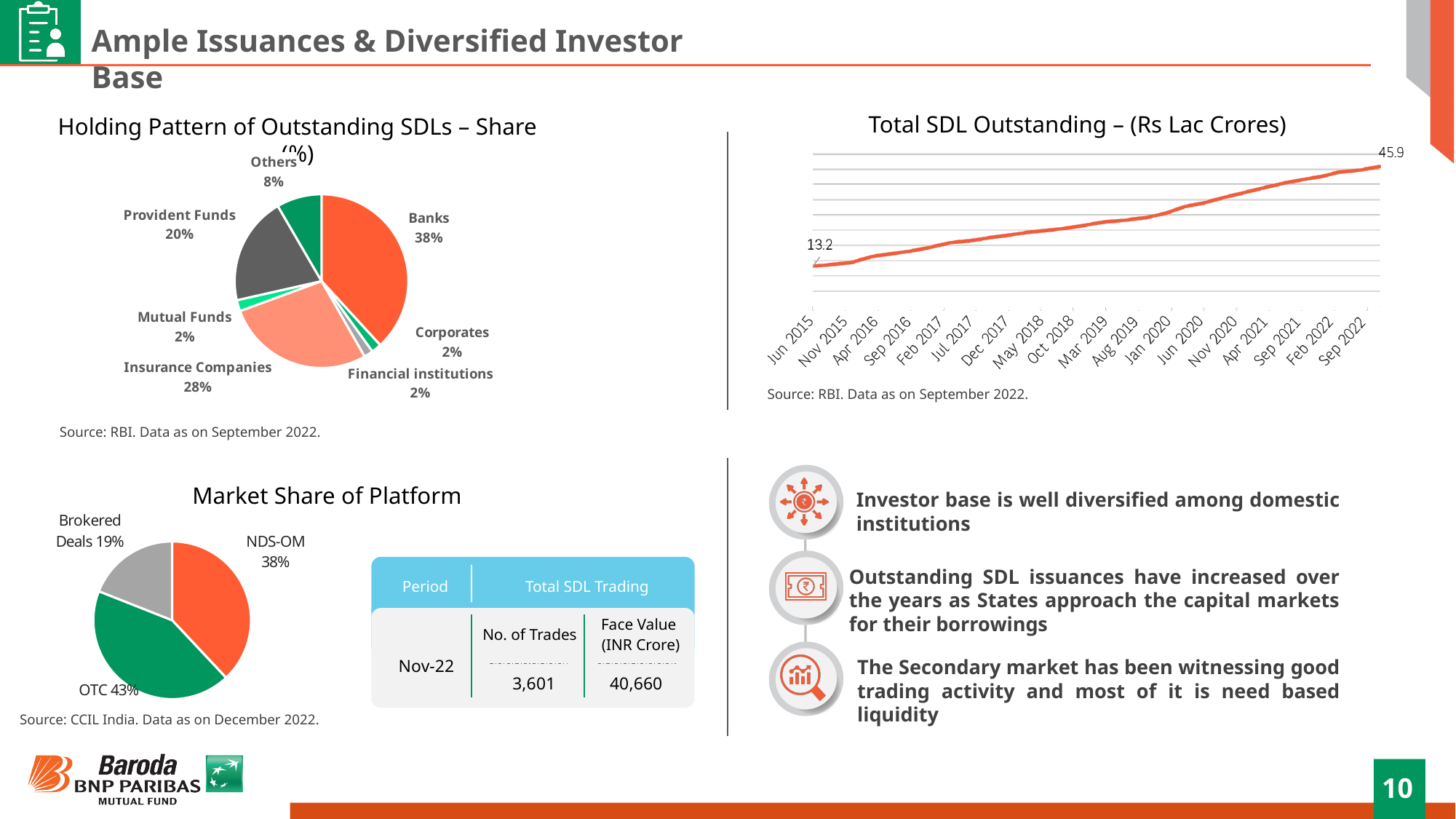
In the 'Total SDL Outstanding' chart, do values rise or fall from Jun 2015 to Sep 2022? Rise In the 'Market Share of Platform' pie chart, what share does OTC have? 43% In the 'Holding Pattern of Outstanding SDLs' pie chart, which category has the largest share? Banks In the 'Holding Pattern of Outstanding SDLs' pie chart, how many categories are shown? 7 In the 'Total SDL Outstanding' chart, what is the value at the start of the series (Jun 2015)? 13.2 In the 'Holding Pattern of Outstanding SDLs' pie chart, what share do Insurance Companies hold? 28% In the 'Market Share of Platform' pie chart, which platform has the smallest share? Brokered Deals In the 'Holding Pattern of Outstanding SDLs' pie chart, which is larger: Provident Funds or Insurance Companies? Insurance Companies What type of chart is 'Total SDL Outstanding – (Rs Lac Crores)'? Line chart In the 'Holding Pattern of Outstanding SDLs' pie chart, what share do Banks hold? 38% In the 'Holding Pattern of Outstanding SDLs' pie chart, what is the difference between the Provident Funds share and the Others share? 12% In the 'Total SDL Outstanding' chart, what is the value at the end of the series (Sep 2022)? 45.9